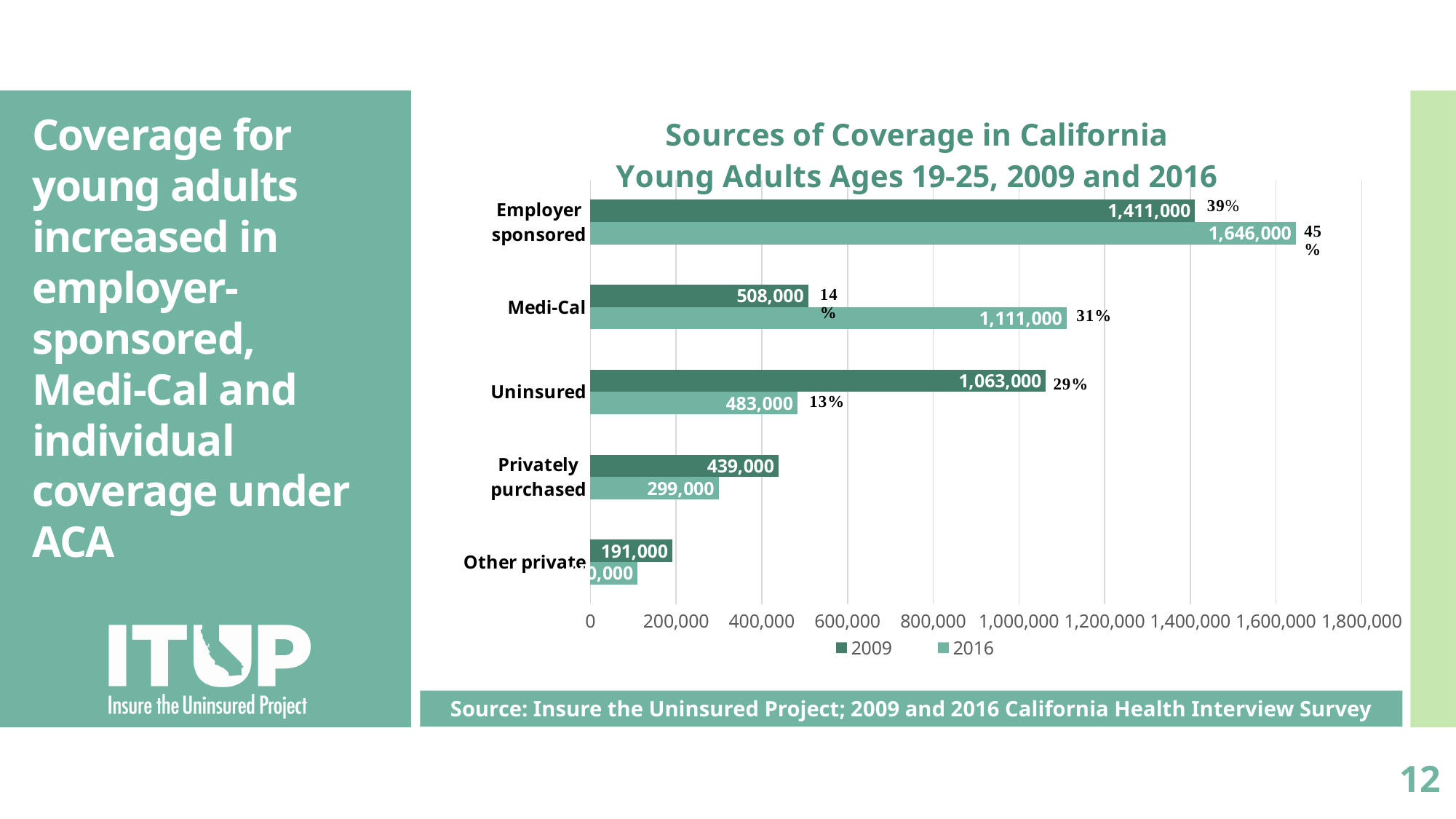
What is the 2016 value for Employer sponsored coverage? 1,646,000 What is the 2009 value for Privately purchased coverage? 439,000 How many coverage categories are shown on the chart? 5 Which is larger for Uninsured: the 2009 value or the 2016 value? 2009 What percentage label is shown next to the 2016 Medi-Cal bar? 31% What type of chart is shown on the slide? Bar chart What is the difference between the 2016 and 2009 values for Medi-Cal? 603,000 How many series does the legend list? 2 What is the 2009 value for Medi-Cal? 508,000 What is the 2016 value for Uninsured? 483,000 Which category has the highest 2016 value? Employer sponsored Which category has the lowest 2009 value? Other private